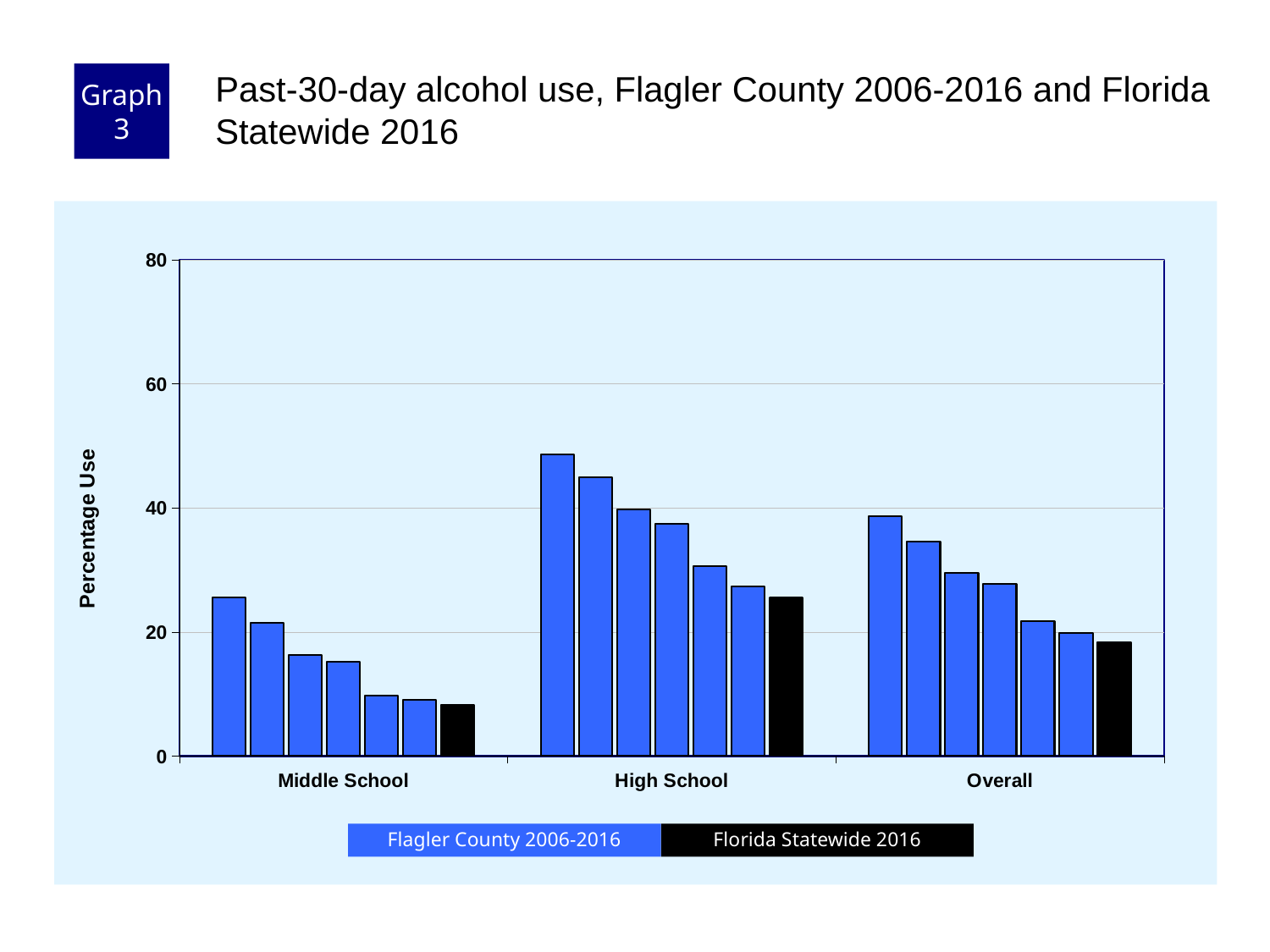
What is the label of the y axis? Percentage Use Which series is shown in black? Florida Statewide 2016 Is the tallest Flagler County bar in the Middle School group greater or less than 20? greater Which category has the lowest Florida Statewide 2016 value? Middle School What kind of chart is shown on the slide? bar chart Which category has the highest Florida Statewide 2016 value? High School Is the Florida Statewide 2016 value for High School greater or less than 20? greater Within the High School group, do the Flagler County 2006-2016 bars rise or fall from left to right? fall How many school-level categories are shown on the x axis? 3 How many series does the legend list? 2 Is the Florida Statewide 2016 value for Middle School greater or less than 20? less